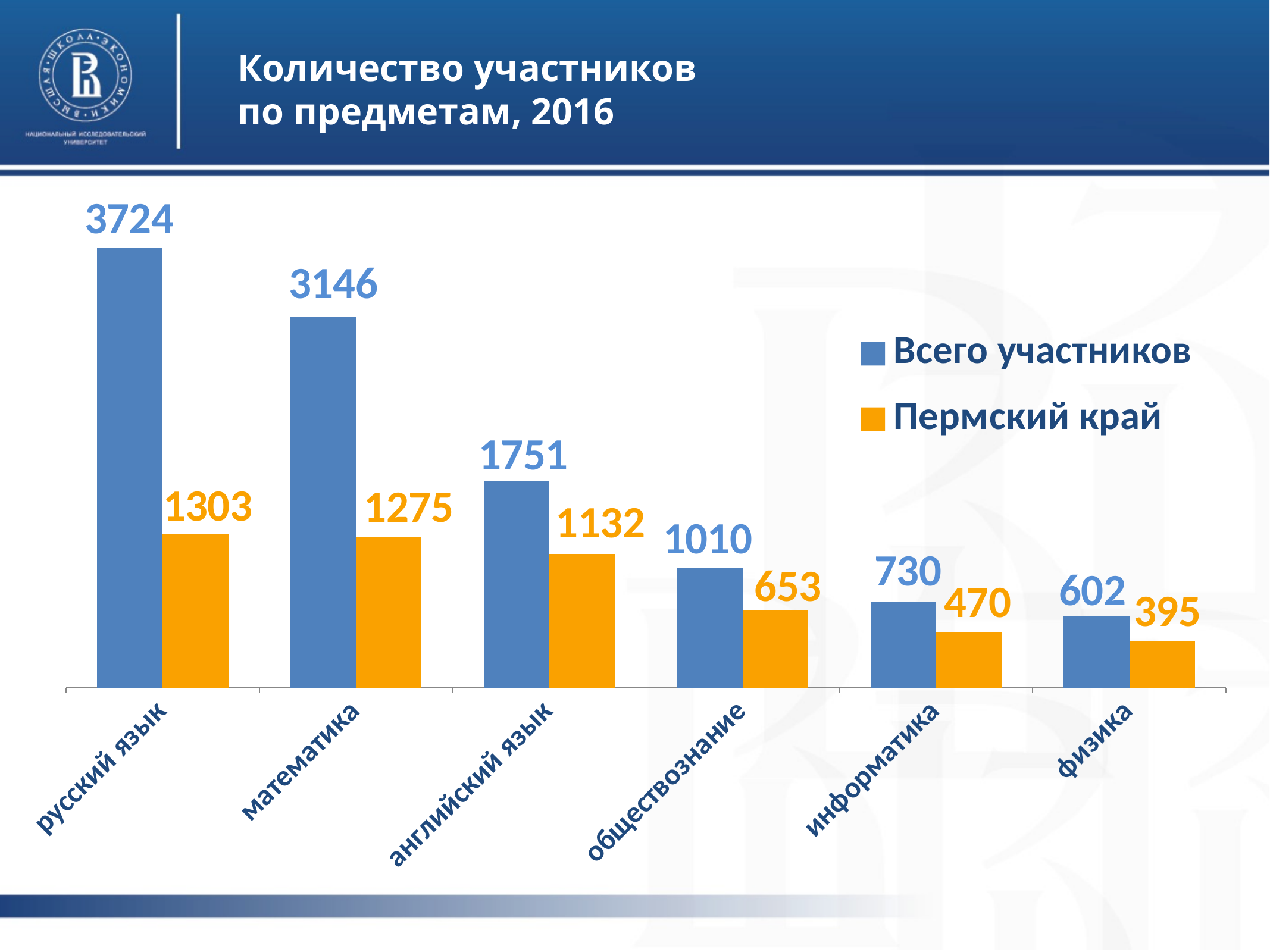
What is the difference between "Всего участников" and "Пермский край" for английский язык? 619 Which subject has the lowest value for "Пермский край"? физика Which is larger: "Пермский край" for обществознание or "Всего участников" for информатика? Всего участников for информатика How many subjects are shown on the x axis? 6 How many series does the legend list? 2 What is the title of the chart? Количество участников по предметам, 2016 What kind of chart is shown on the slide? bar chart Do the values for "Всего участников" rise or fall from left to right along the x axis? fall What is the value of "Пермский край" for математика? 1275 Which subject has the highest value for "Всего участников"? русский язык What is the value of "Всего участников" for русский язык? 3724 What is the value of "Пермский край" for физика? 395